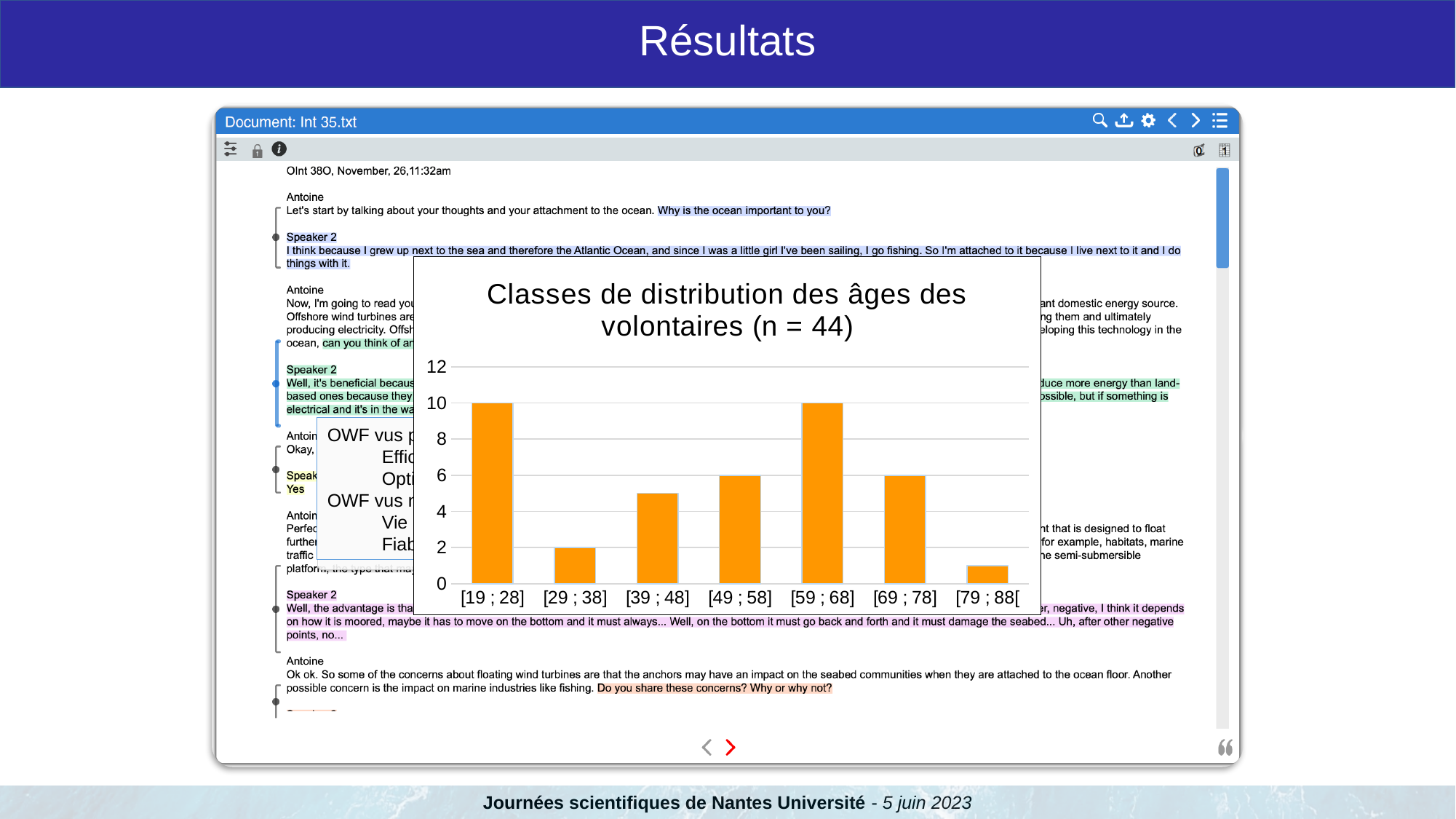
What is the value for the age class [69 ; 78]? 6 What is the value for the age class [59 ; 68]? 10 Is the value for the age class [79 ; 88[ greater or less than 2? less Which age class has the lowest value? [79 ; 88[ What is the title of the chart? Classes de distribution des âges des volontaires (n = 44) How many age classes are shown on the x axis? 7 What is the value for the age class [29 ; 38]? 2 Is the value for the age class [39 ; 48] greater or less than 4? greater Which has the larger value, [49 ; 58] or [29 ; 38]? [49 ; 58] What kind of chart is shown? bar chart What is the value for the age class [19 ; 28]? 10 What is the difference between the values for [19 ; 28] and [29 ; 38]? 8